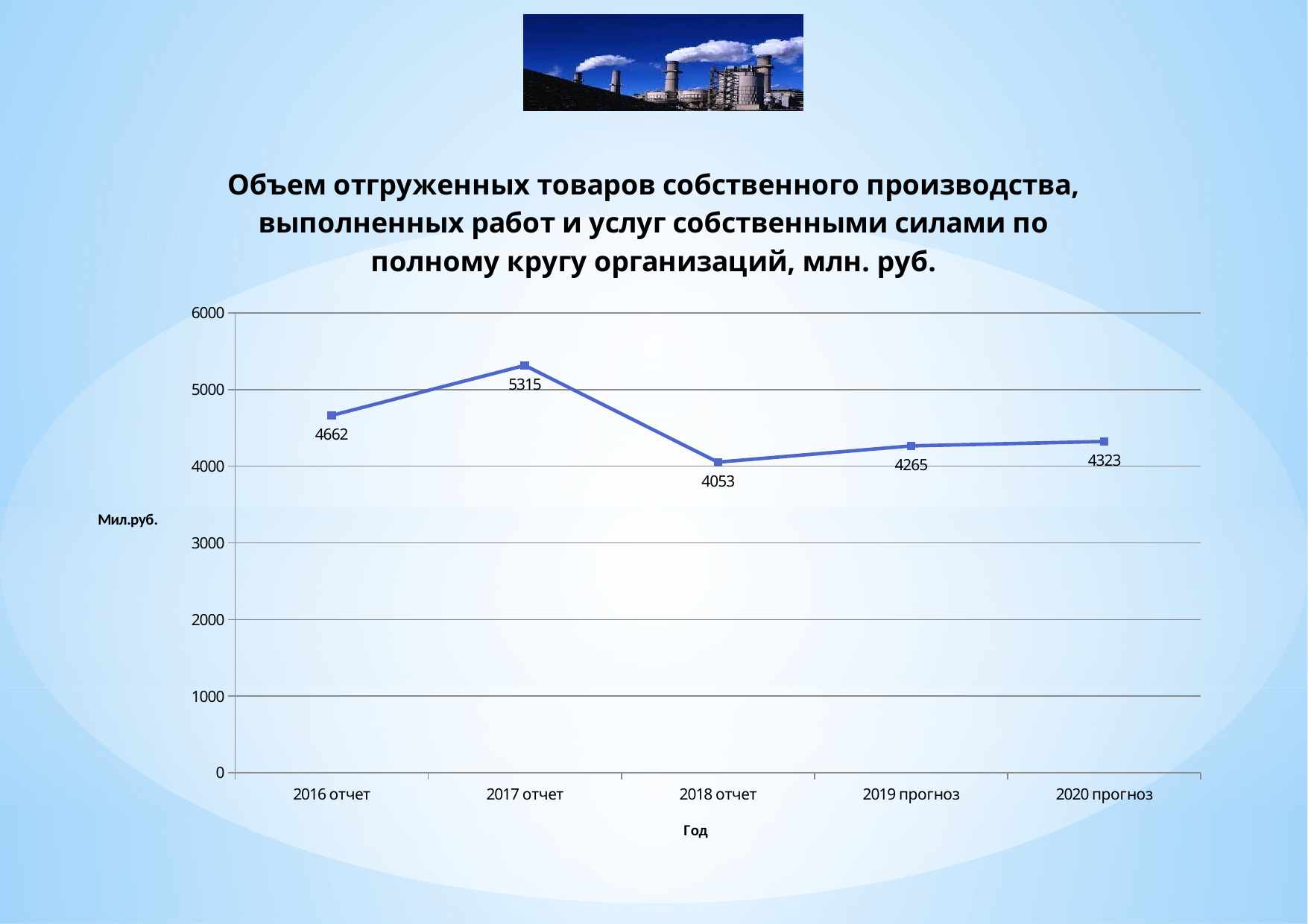
Which year has the lowest value? 2018 отчет What is the difference between the values for 2017 отчет and 2018 отчет? 1262 What is the label of the vertical axis? Мил.руб. How many years are plotted on the chart? 5 What is the value for 2020 прогноз? 4323 What is the difference between the values for 2020 прогноз and 2019 прогноз? 58 Which is larger, the value for 2016 отчет or the value for 2020 прогноз? 2016 отчет Which year has the highest value? 2017 отчет What is the value for 2018 отчет? 4053 What is the value for 2017 отчет? 5315 Is the value for 2016 отчет greater or less than 5000? less What kind of chart is shown on the slide? line chart